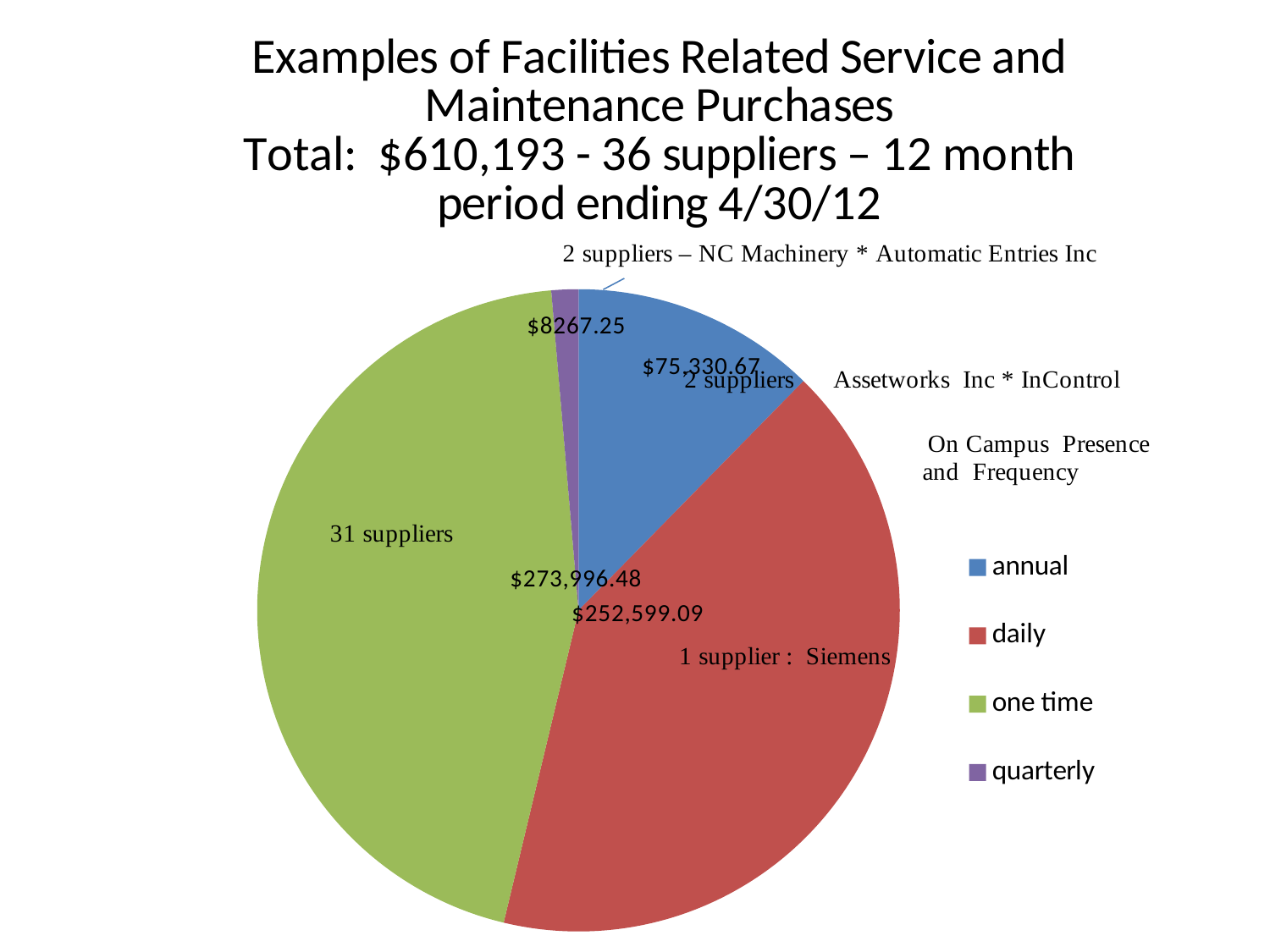
What type of chart is shown on the slide? pie chart Which category has the smallest slice in the pie chart? quarterly Which is larger in the pie chart, the annual slice or the daily slice? daily Which category has the largest slice in the pie chart? one time What is the value of the annual slice in the pie chart? $75,330.67 What is the value of the quarterly slice in the pie chart? $8267.25 What is the difference between the annual value and the quarterly value in the pie chart? $67,063.42 What is the difference between the one time value and the daily value in the pie chart? $21,397.39 What is the value of the daily slice in the pie chart? $252,599.09 How many slices does the pie chart have? 4 Which legend entry is shown in green in the pie chart? one time What is the value of the one time slice in the pie chart? $273,996.48